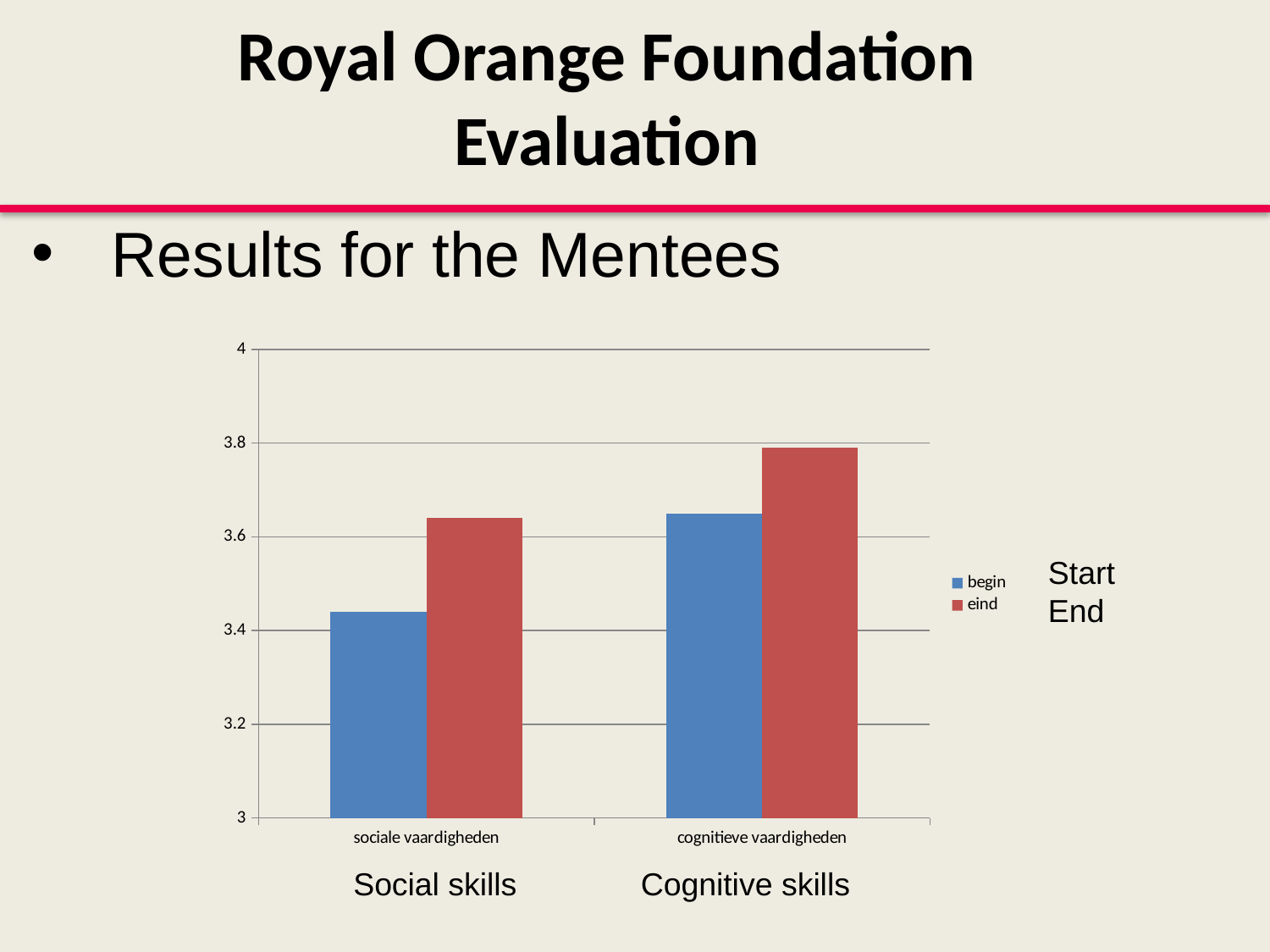
Which category has the highest bar in the chart? cognitieve vaardigheden (eind) Is the begin value for sociale vaardigheden greater or less than 3.6? less What kind of chart is shown on the slide? bar chart Is the eind value for sociale vaardigheden greater or less than 3.6? greater Do the begin values rise or fall from sociale vaardigheden to cognitieve vaardigheden? rise For sociale vaardigheden, which is larger: begin or eind? eind Is the eind value for cognitieve vaardigheden greater or less than 3.6? greater How many series does the chart legend list? 2 How many categories are shown on the x axis of the chart? 2 What are the two series named in the chart legend? begin and eind Which bar is the lowest in the chart? sociale vaardigheden (begin) For cognitieve vaardigheden, which is larger: begin or eind? eind